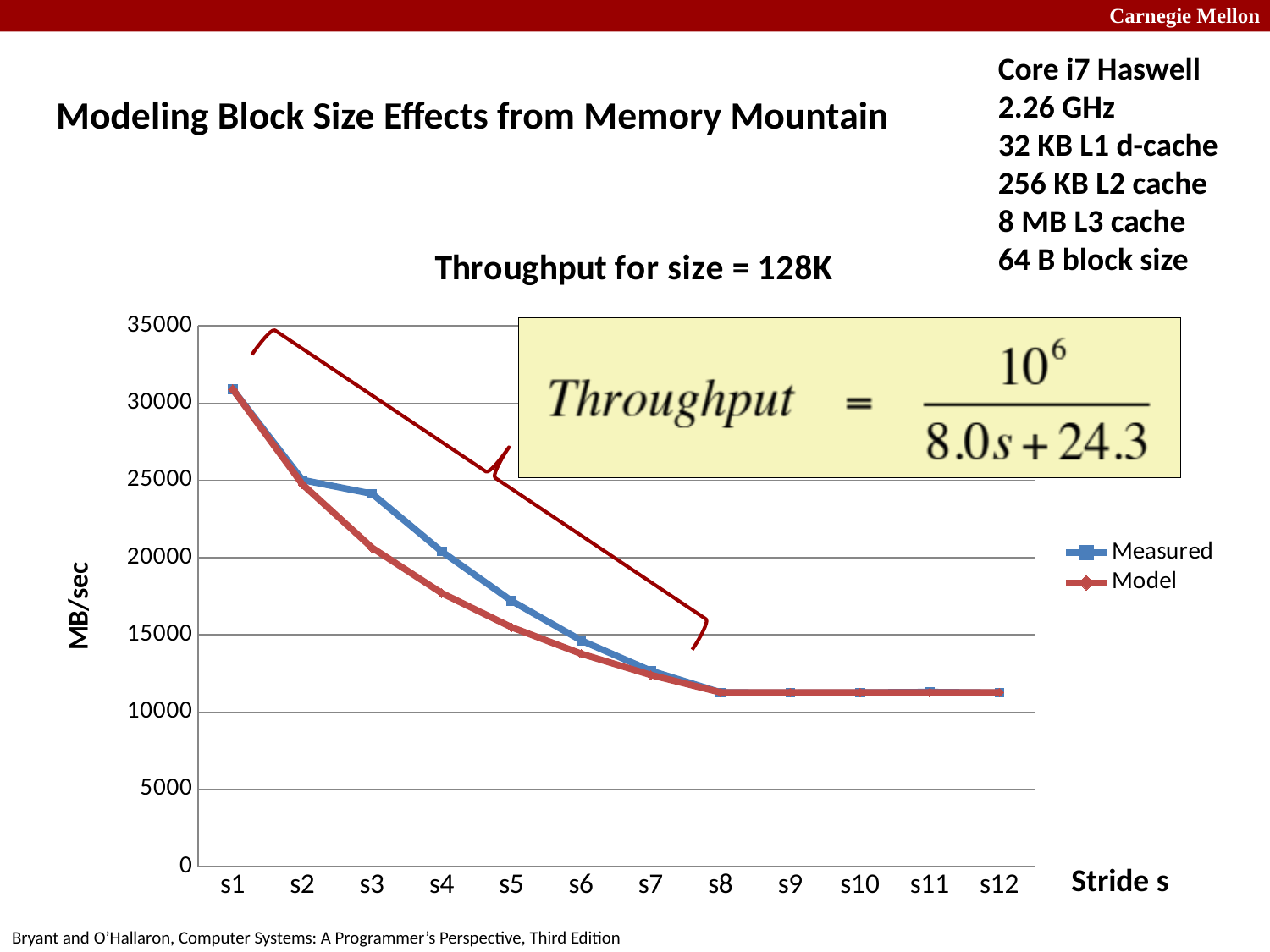
What kind of chart is shown on the slide? line chart Is the Model value at s4 greater or less than 20000? less Is the Model value at s6 greater or less than 15000? less At stride s3, which series has the larger value, Measured or Model? Measured How many stride values are plotted along the x axis? 12 Is the Measured value at s3 greater or less than 20000? greater At which stride is the Model throughput highest? s1 What is the title of the chart? Throughput for size = 128K At which stride is the Measured throughput highest? s1 How many series does the legend list? 2 Do the Measured throughput values rise or fall as the stride increases from s1 to s12? fall